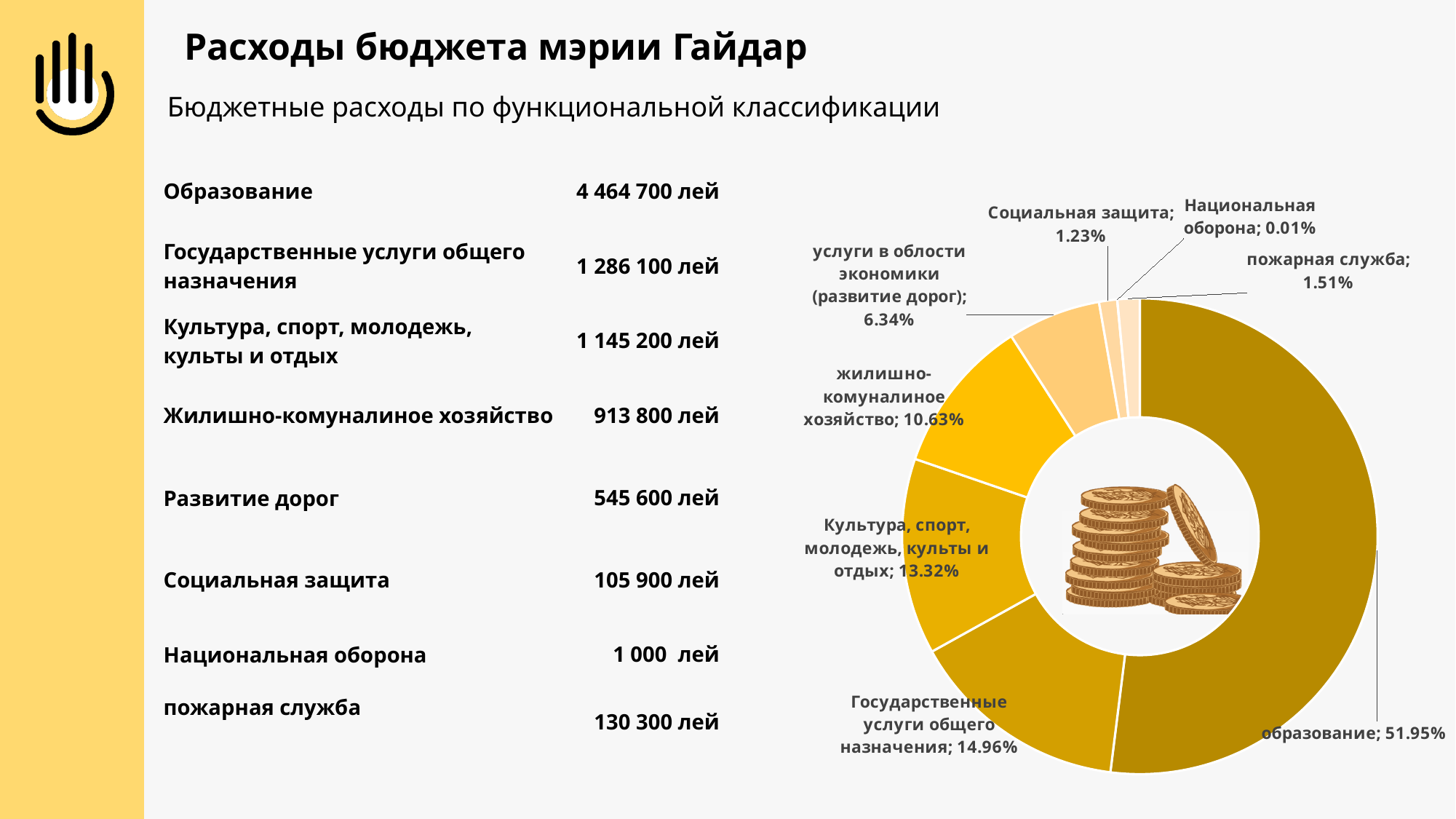
Which category has the largest share in the chart? образование Which has a larger share in the chart: Культура, спорт, молодежь, культы и отдых or жилишно-комуналиное хозяйство? Культура, спорт, молодежь, культы и отдых What percentage is shown for услуги в области экономики (развитие дорог) in the chart? 6.34% What kind of chart is shown on the slide? Doughnut (pie) chart What is the difference in percentage points between образование and Государственные услуги общего назначения in the chart? 36.99% What percentage is shown for жилишно-комуналиное хозяйство in the chart? 10.63% Which category has the smallest share in the chart? Национальная оборона What percentage is shown for пожарная служба in the chart? 1.51% What is the subtitle shown above the chart on the slide? Бюджетные расходы по функциональной классификации What share of the budget expenses does образование account for in the chart? 51.95% How many slices does the chart have? 8 What percentage is shown for Государственные услуги общего назначения in the chart? 14.96%